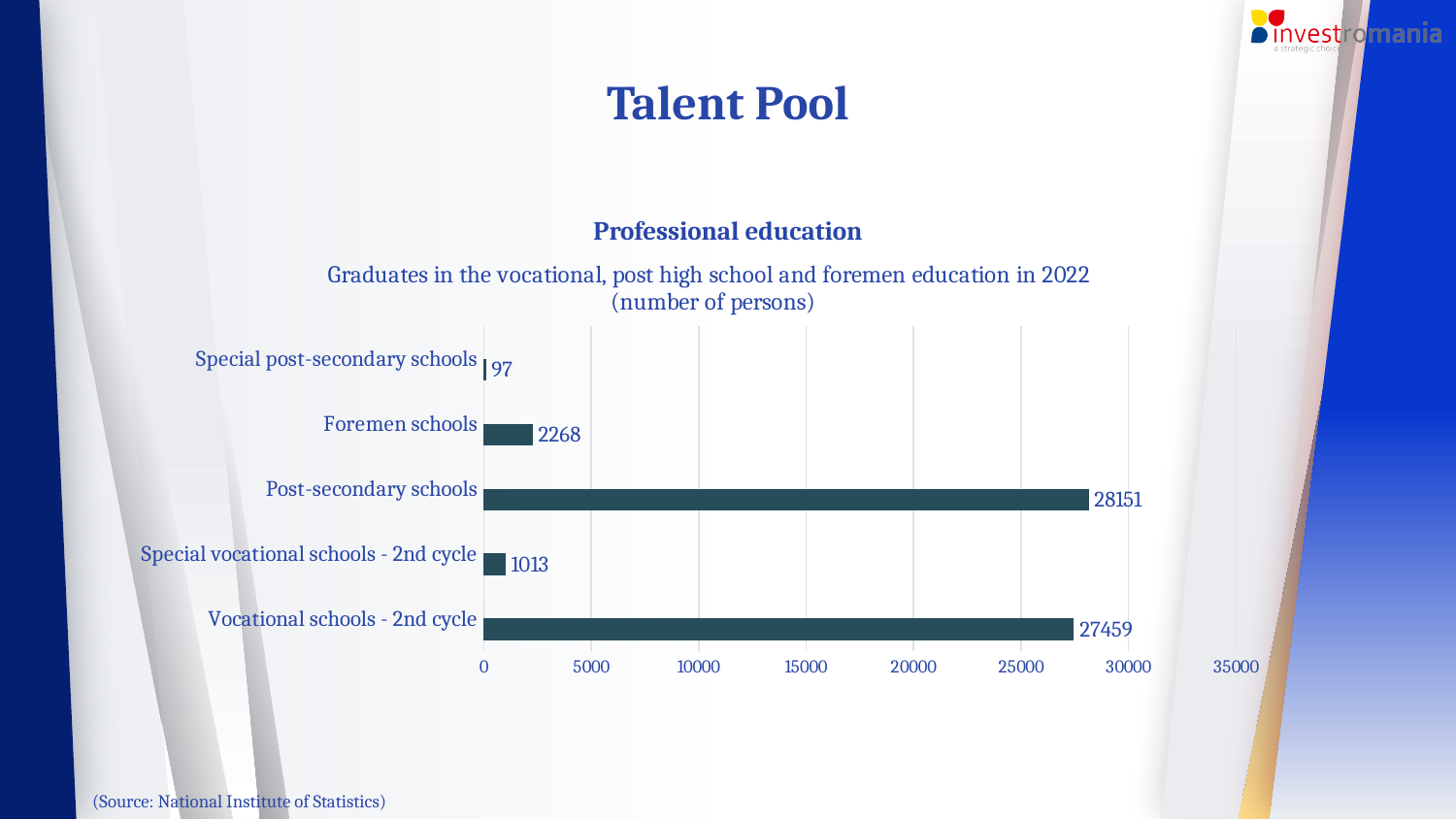
What is the title of the chart? Graduates in the vocational, post high school and foremen education in 2022 (number of persons) Which category has the highest number of graduates? Post-secondary schools What is the value for Foremen schools? 2268 What is the value for Special vocational schools - 2nd cycle? 1013 How many graduates did Post-secondary schools have in 2022? 28151 Which is larger, Foremen schools or Special vocational schools - 2nd cycle? Foremen schools How many categories are shown in the chart? 5 What is the difference between Post-secondary schools and Vocational schools - 2nd cycle? 692 What is the value for Vocational schools - 2nd cycle? 27459 What kind of chart is shown on the slide? Bar chart Is the value for Post-secondary schools greater or less than 25000? greater Which category has the lowest number of graduates? Special post-secondary schools